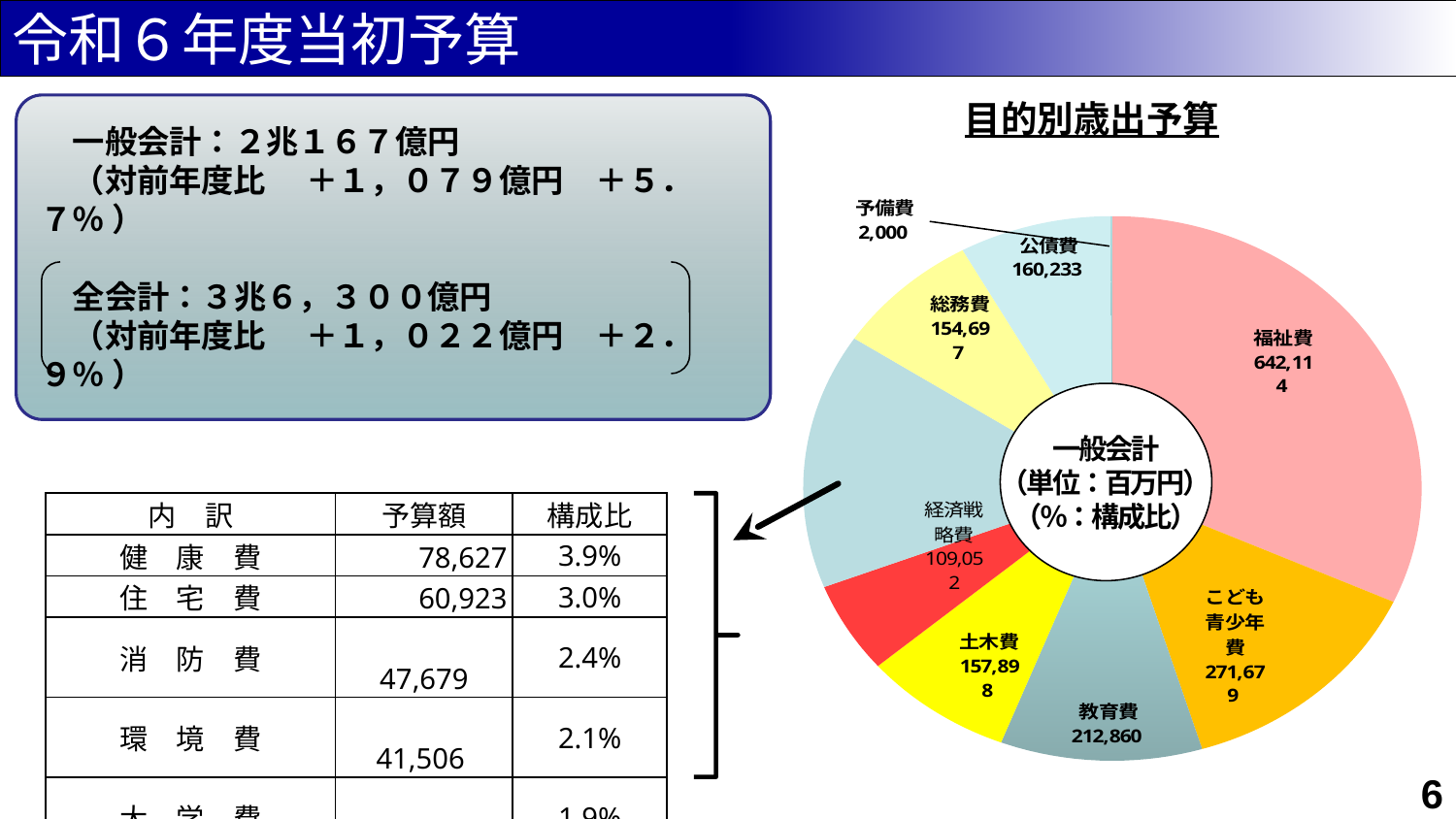
What is the value for 福祉費 in the pie chart? 642,114 What is the value for 予備費 in the pie chart? 2,000 Which category has the largest slice in the pie chart? 福祉費 Which category has the smallest slice in the pie chart? 予備費 What is the difference between 福祉費 and こども青少年費 in the pie chart? 370,435 What unit is stated in the centre of the pie chart? 百万円 Which is larger in the pie chart, 公債費 or 経済戦略費? 公債費 What is the title of the pie chart? 目的別歳出予算 What is the difference between 教育費 and 土木費 in the pie chart? 54,962 What is the value for 公債費 in the pie chart? 160,233 What kind of chart is shown under the title 目的別歳出予算? pie chart What is the value for 教育費 in the pie chart? 212,860